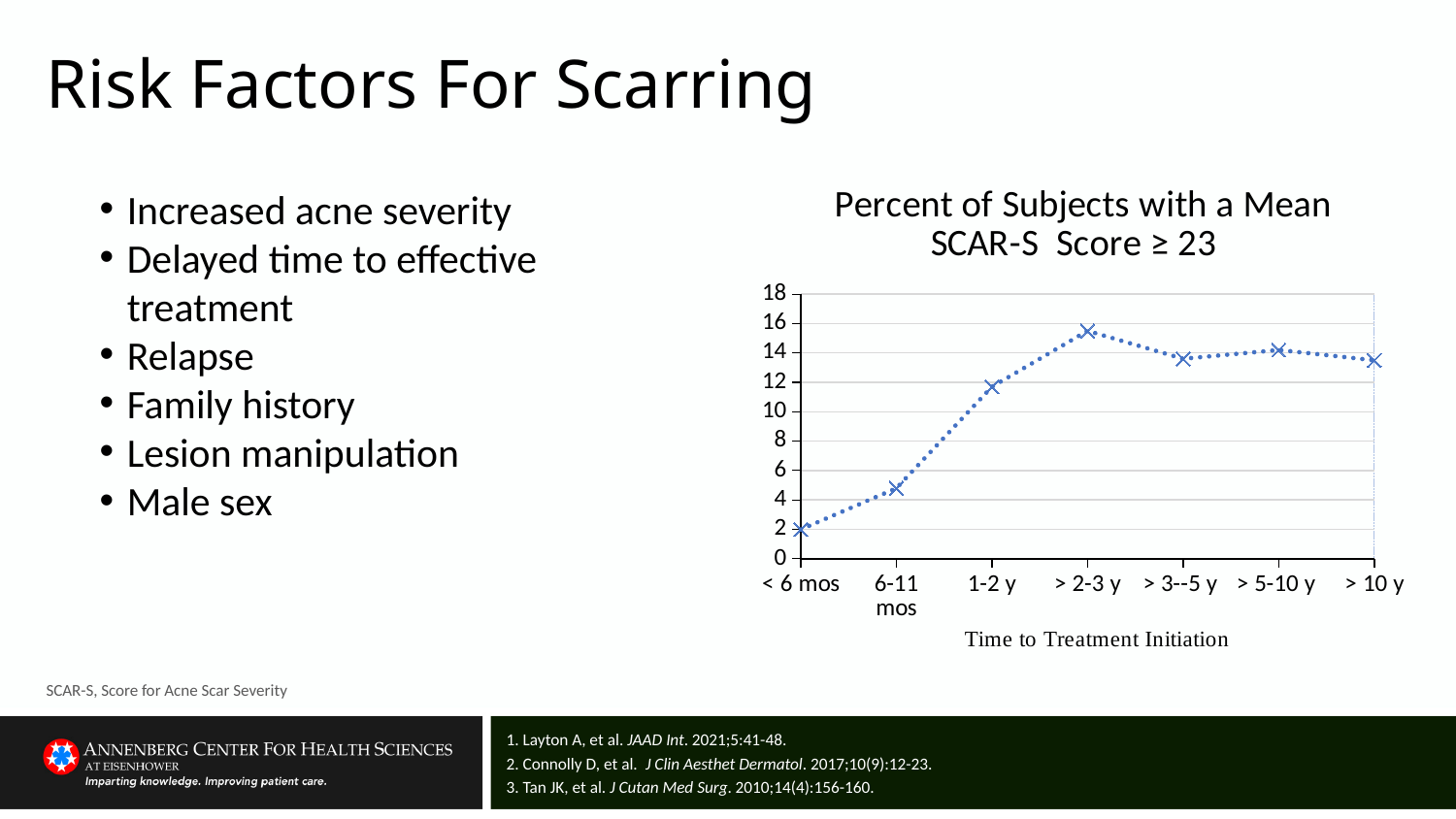
Which has a higher value, 6-11 mos or 1-2 y? 1-2 y What is the label of the x axis? Time to Treatment Initiation What kind of chart is shown on the slide? line chart Is the value for < 6 mos greater or less than 4? less Which time-to-treatment category has the highest percent of subjects with a mean SCAR-S score ≥ 23? > 2-3 y Which has a higher value, > 2-3 y or > 3--5 y? > 2-3 y Is the value for 1-2 y greater or less than 10? greater Is the value for > 2-3 y greater or less than 14? greater How many time-to-treatment categories are plotted on the x axis? 7 Which time-to-treatment category has the lowest percent of subjects with a mean SCAR-S score ≥ 23? < 6 mos Do the values rise or fall from < 6 mos to > 2-3 y? rise